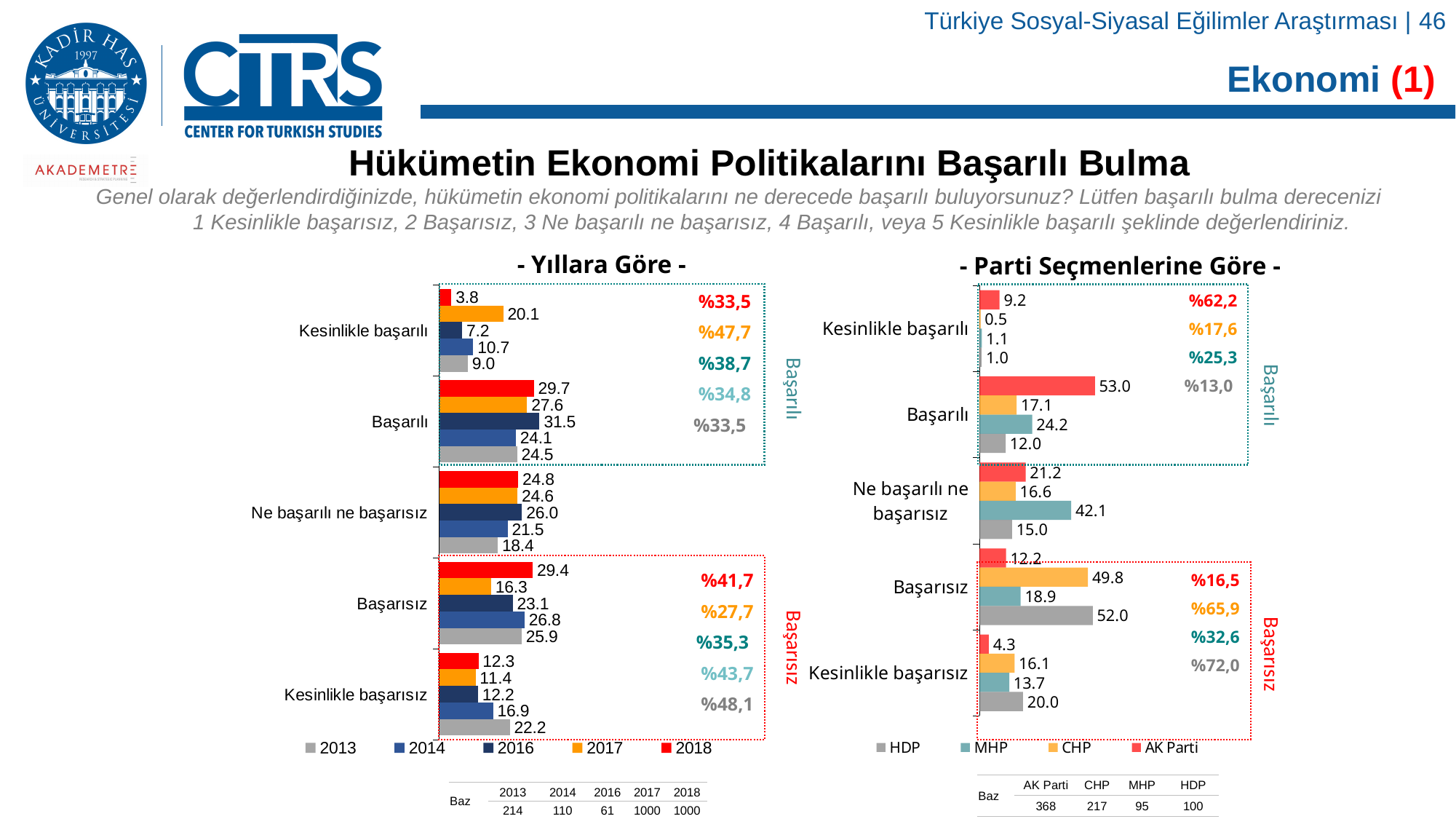
In the '- Yıllara Göre -' chart, what is the difference between the 2018 and 2017 values in the 'Başarısız' category? 13.1 In the '- Yıllara Göre -' chart, what is the value for 2016 in the 'Başarılı' category? 31.5 In the '- Parti Seçmenlerine Göre -' chart, which party has the highest value in the 'Ne başarılı ne başarısız' category? MHP In the '- Yıllara Göre -' chart, which year has the highest value in the 'Kesinlikle başarısız' category? 2013 In the '- Parti Seçmenlerine Göre -' chart, what is the value for AK Parti in the 'Başarılı' category? 53.0 In the '- Parti Seçmenlerine Göre -' chart, which is larger in the 'Başarısız' category: CHP or HDP? HDP In the '- Parti Seçmenlerine Göre -' chart, what is the difference between the HDP and AK Parti values in the 'Kesinlikle başarısız' category? 15.7 In the '- Yıllara Göre -' chart, which year has the lowest value in the 'Kesinlikle başarılı' category? 2018 What type of chart is the '- Parti Seçmenlerine Göre -' chart? Bar chart In the '- Yıllara Göre -' chart, what is the value for 2018 in the 'Kesinlikle başarılı' category? 3.8 How many series does the legend of the '- Yıllara Göre -' chart list? 5 How many categories are shown on the '- Parti Seçmenlerine Göre -' chart? 5